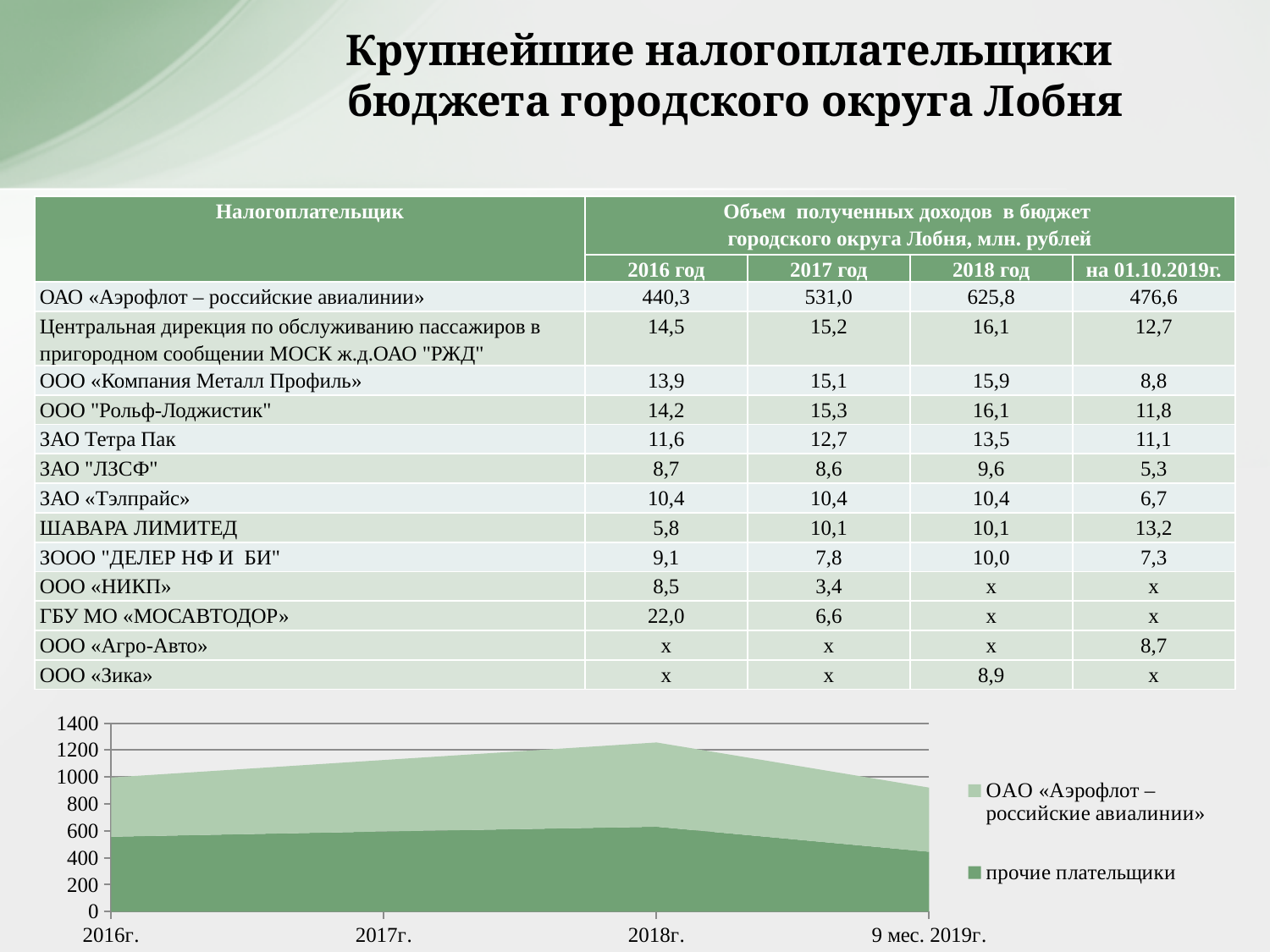
How many periods are shown along the x axis of the chart? 4 In which period is the total height of the stacked areas lowest? 9 мес. 2019г. Which series is listed first in the chart legend? ОАО «Аэрофлот – российские авиалинии» Is the total of the stacked areas in 2018г. greater or less than 1200? greater What is the label of the last point on the x axis of the chart? 9 мес. 2019г. Is the total of the stacked areas in 9 мес. 2019г. greater or less than 1000? less How many series does the legend of the chart list? 2 Is the value for прочие плательщики in 9 мес. 2019г. greater or less than 600? less Does the total of the stacked areas rise or fall from 2016г. to 2018г.? rise What kind of chart is shown at the bottom of the slide? area chart In which period is the total height of the stacked areas highest? 2018г.